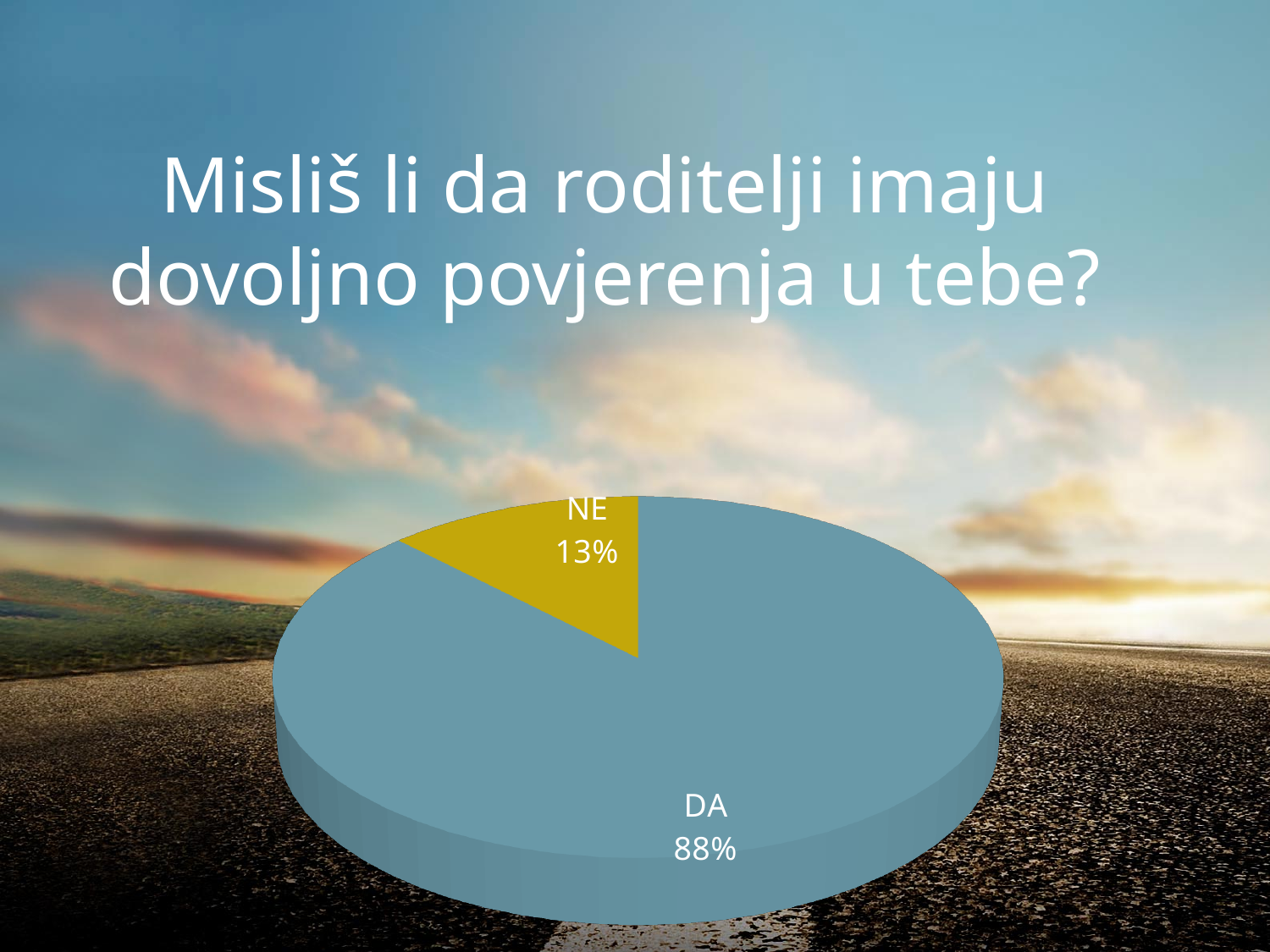
What percentage of respondents answered NE? 13% Which slice is larger, DA or NE? DA What percentage of respondents answered DA? 88% How many slices does the pie chart have? 2 Which answer has the smallest share of the pie? NE What share of the pie does the DA slice represent? 88% What is the difference in percentage points between the DA and NE slices? 75 What kind of chart is shown on the slide? pie chart What is the title of the slide containing the chart? Misliš li da roditelji imaju dovoljno povjerenja u tebe? What colour is the NE slice of the pie chart? yellow Which answer has the largest share of the pie? DA